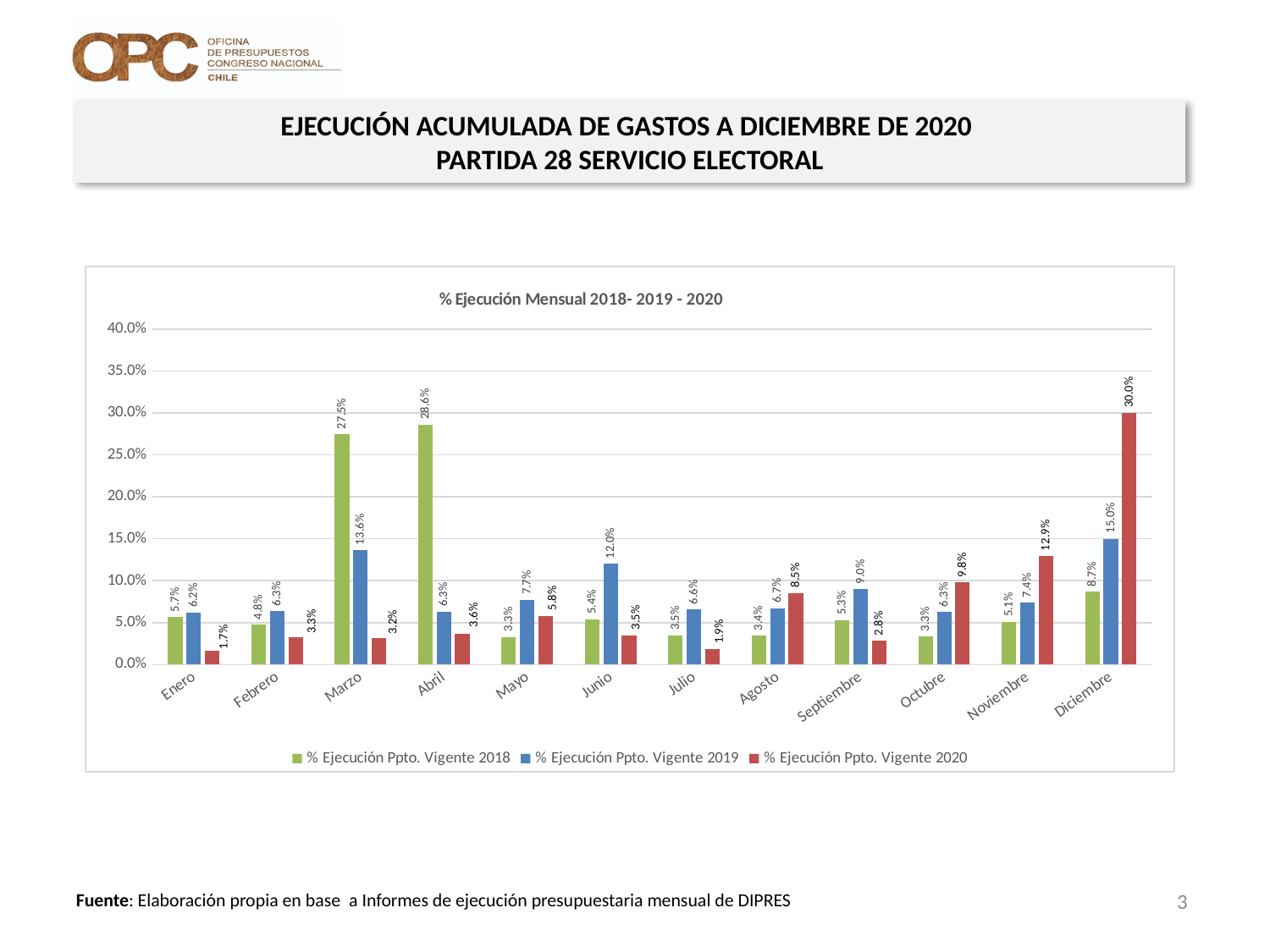
What type of chart is shown on the slide? Bar chart In which month is the % Ejecución Ppto. Vigente 2020 series lowest? Enero What is the value for % Ejecución Ppto. Vigente 2018 in Abril? 28.6% What is the value for % Ejecución Ppto. Vigente 2020 in Diciembre? 30.0% How many series does the legend list? 3 Which is larger in Octubre: the 2019 value or the 2020 value? The 2020 value (9.8%) How many months (categories) are shown on the x axis? 12 In which month is the % Ejecución Ppto. Vigente 2018 series highest? Abril What is the value for % Ejecución Ppto. Vigente 2019 in Junio? 12.0% What is the title of the chart? % Ejecución Mensual 2018- 2019 - 2020 Is the value for % Ejecución Ppto. Vigente 2019 in Diciembre greater or less than 10.0%? greater What is the difference between the 2018 and 2019 values in Marzo? 13.9%